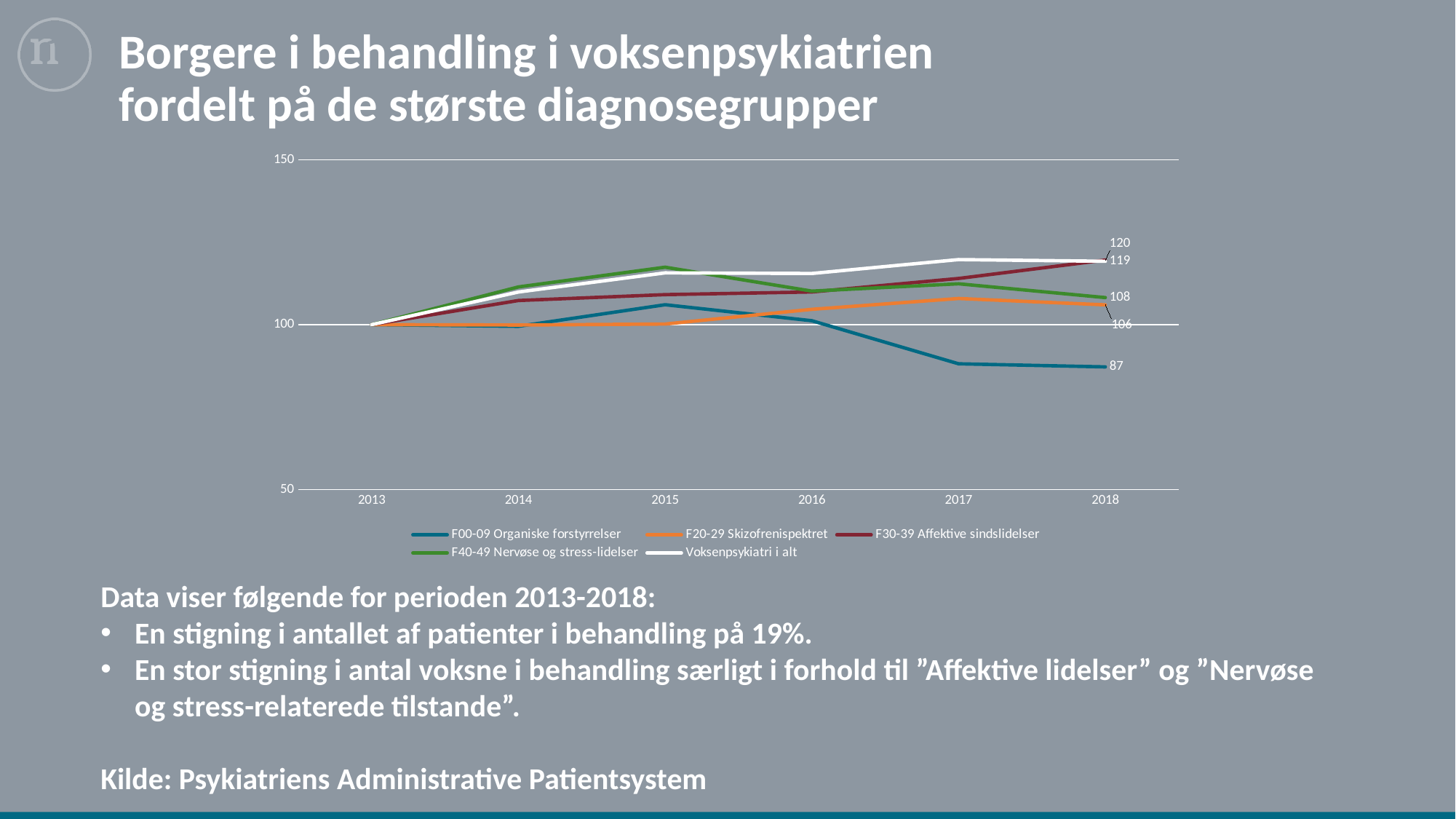
What is the value for F30-39 Affektive sindslidelser in 2018? 120 How many years are shown on the x axis? 6 In 2018, which is larger: F40-49 Nervøse og stress-lidelser or F20-29 Skizofrenispektret? F40-49 Nervøse og stress-lidelser What is the value for all series in 2013? 100 Does the line for F00-09 Organiske forstyrrelser rise or fall from 2015 to 2018? fall What kind of chart is shown on the slide? line chart What is the difference between Voksenpsykiatri i alt and F00-09 Organiske forstyrrelser in 2018? 32 What is the value for Voksenpsykiatri i alt in 2018? 119 How many series does the legend list? 5 What is the value for F00-09 Organiske forstyrrelser in 2018? 87 Which series has the lowest value in 2018? F00-09 Organiske forstyrrelser Is the value for F00-09 Organiske forstyrrelser in 2017 greater or less than 100? less